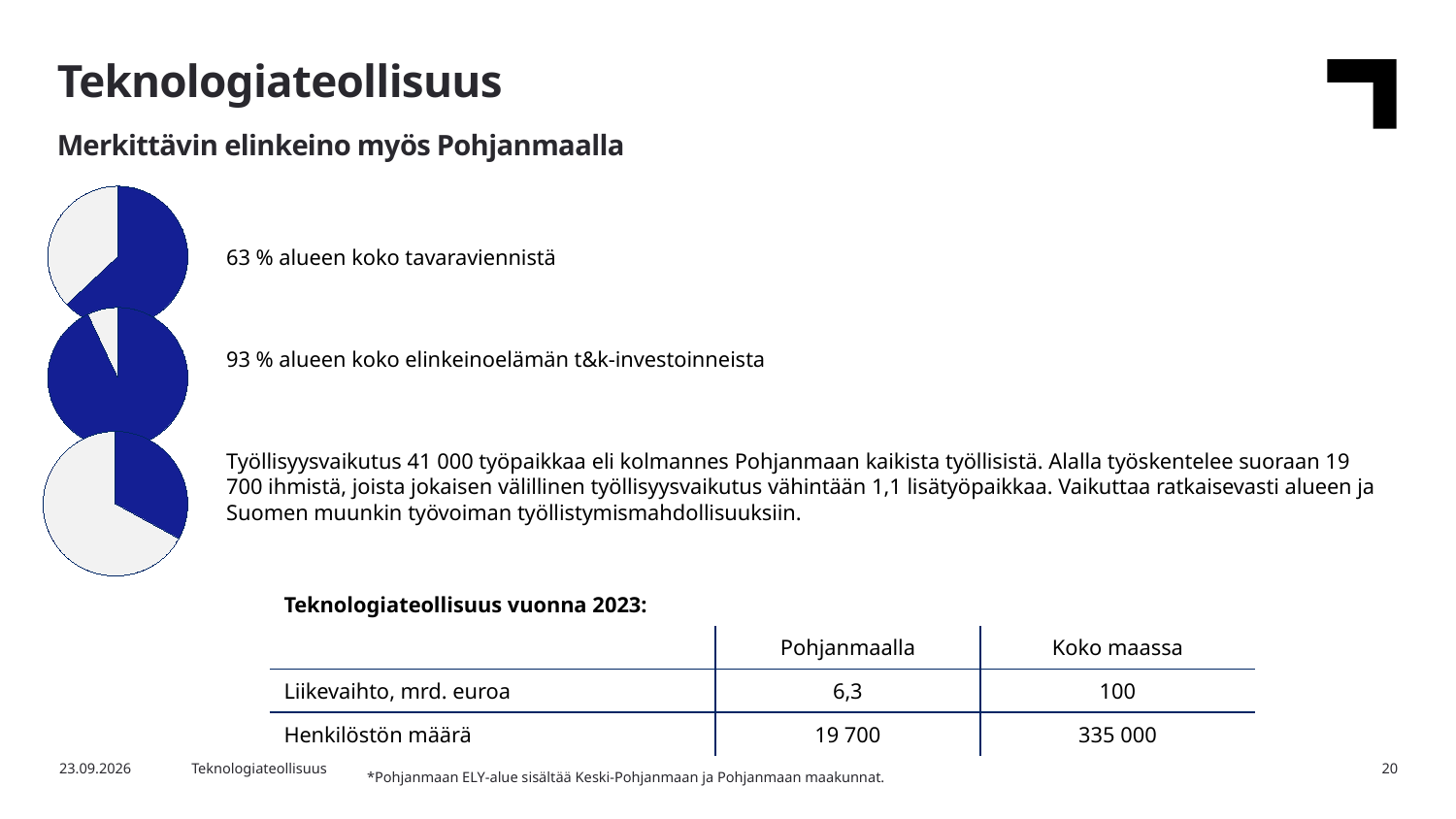
Which pie chart has the largest blue slice: the top, middle or bottom one? Middle Which pie chart has the smallest blue slice: the top, middle or bottom one? Bottom What kind of charts are shown on the left side of the slide? Pie charts How many pie charts are on the slide? 3 Is the blue slice in the top pie chart greater or less than half of the pie? greater In the middle pie chart, what share of the region's business R&D investments (t&k-investoinnit) does the blue slice represent? 93 % In the top pie chart, what share of the region's total goods exports (tavaravienti) does the blue slice represent? 63 % Is the blue slice larger in the top pie chart or in the middle pie chart? Middle Is the blue slice in the bottom pie chart greater or less than half of the pie? less What colour is used for the highlighted slice in each pie chart? Blue Which pie chart corresponds to the statement about employment effect (työllisyysvaikutus): the top, middle or bottom one? Bottom